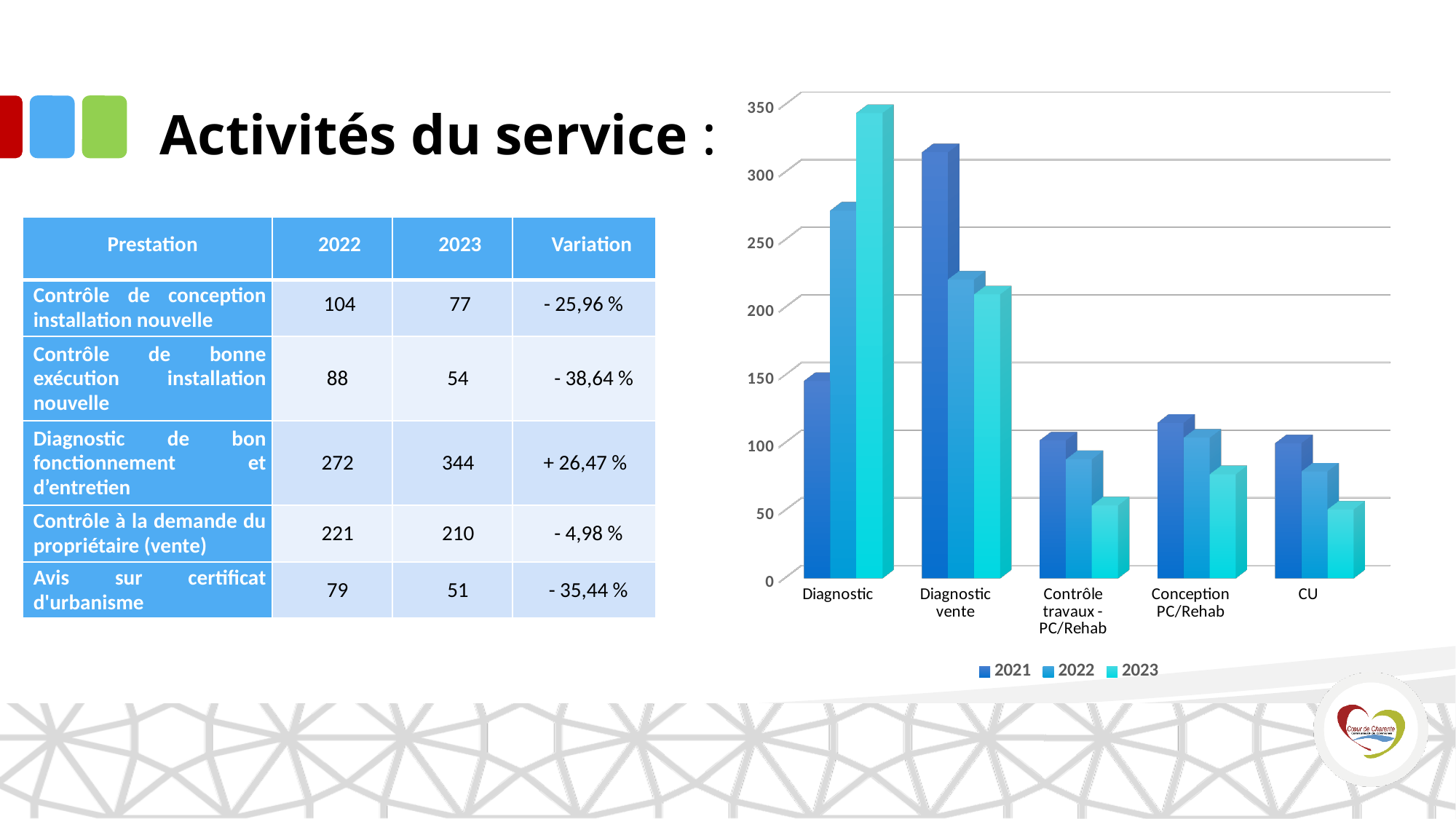
How many categories are shown on the x axis of the chart? 5 Which category has the highest 2022 value? Diagnostic Which category has the tallest bar in the chart? Diagnostic Which years are listed in the chart legend? 2021, 2022, 2023 Do the values for CU rise or fall from 2021 to 2023? fall Is the 2023 value for Diagnostic greater or less than 300? greater What kind of chart is shown on the slide? bar chart Which category has the highest 2021 value? Diagnostic vente Which is larger: the 2023 value for Diagnostic or the 2021 value for Diagnostic vente? 2023 value for Diagnostic Is the 2022 value for Diagnostic vente greater or less than 200? greater Is the 2022 value for Contrôle travaux - PC/Rehab greater or less than 100? less How many series does the chart legend list? 3